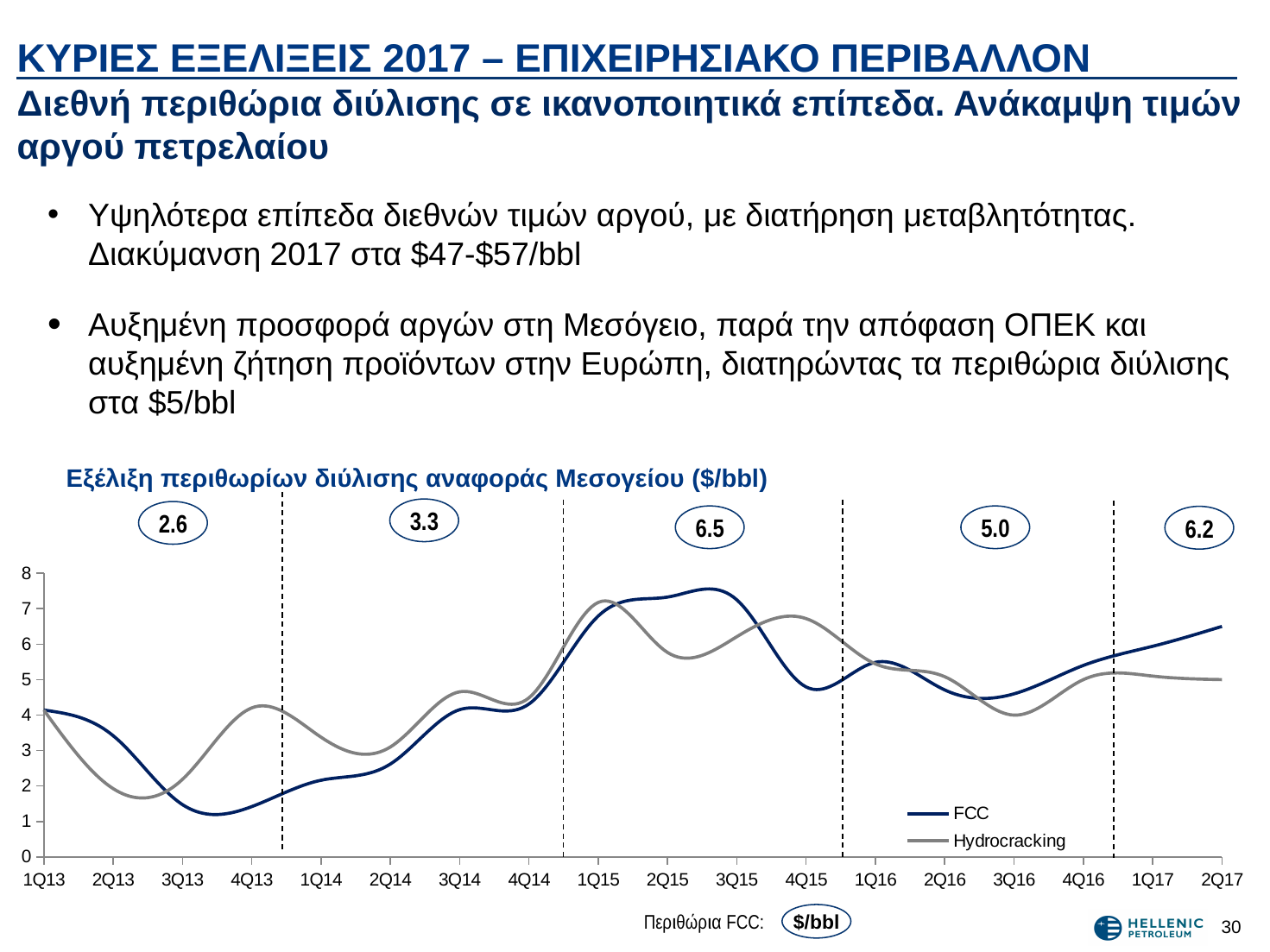
What is the first quarter labelled on the x axis of the chart? 1Q13 What is the difference between the circled values 6.5 and 5.0 shown above the chart? 1.5 Is the FCC value at 3Q13 greater or less than 2? less Which of the circled annual values above the chart is the lowest? 2.6 How many quarters are labelled along the x axis of the chart? 18 What kind of chart is shown on the slide? line chart What circled value is shown above the 1Q17–2Q17 segment of the chart? 6.2 At 4Q13, which series has the higher value, FCC or Hydrocracking? Hydrocracking How many series does the chart legend list? 2 Is the FCC value at 2Q17 greater or less than 6? greater What are the two series named in the chart legend? FCC and Hydrocracking Which of the circled annual values above the chart is the highest? 6.5